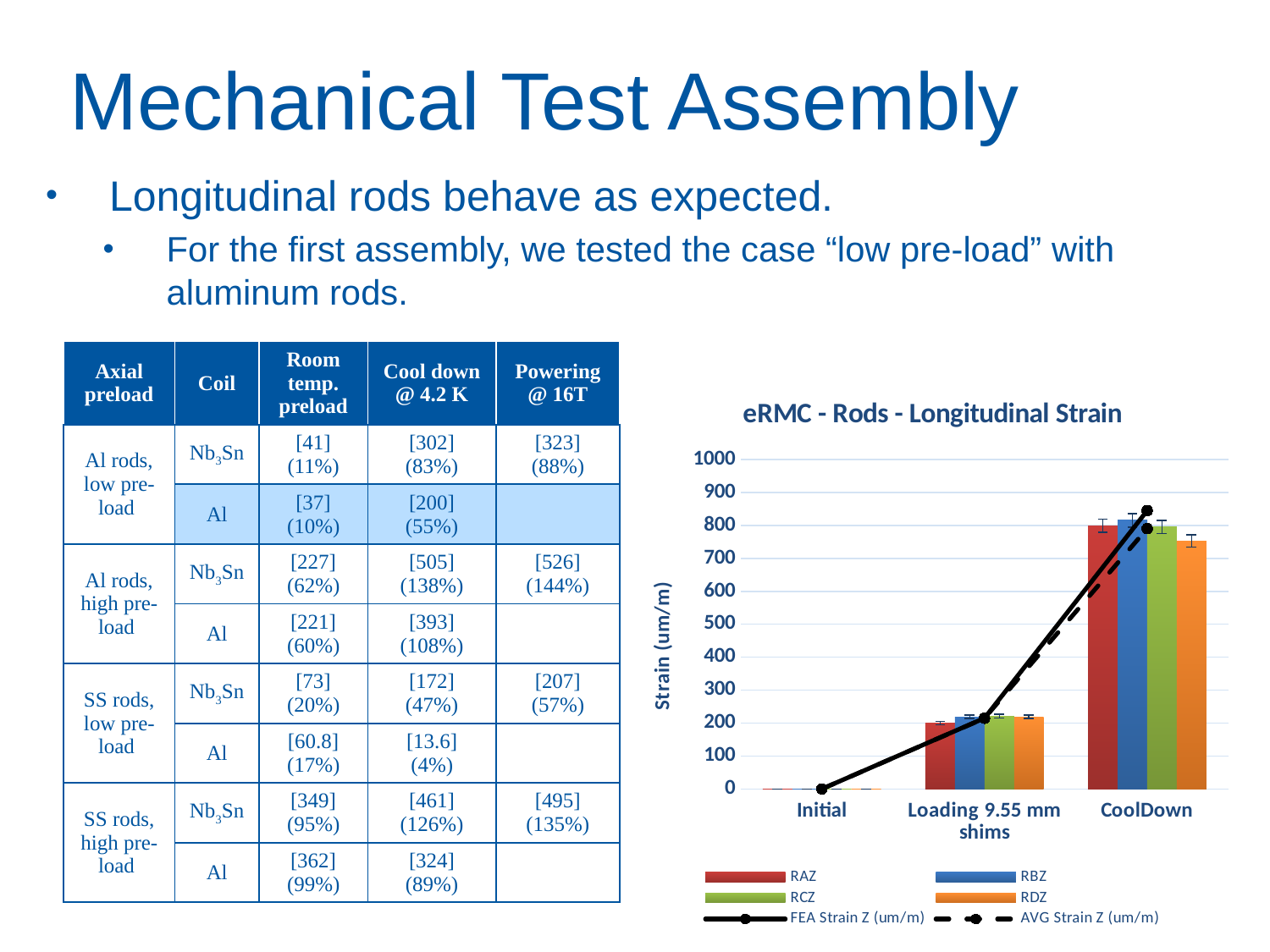
Which bar series has the lowest value at CoolDown? RDZ What is the label of the y axis of the chart? Strain (um/m) What kind of chart is shown on the slide? combination bar and line chart Is the value for RBZ at Loading 9.55 mm shims greater or less than 100? greater Is the value for RDZ at CoolDown greater or less than 800? less Is the value for RAZ at CoolDown greater or less than 700? greater What is the title of the chart on the slide? eRMC - Rods - Longitudinal Strain How many categories are shown on the x axis of the chart? 3 Do the strain values rise or fall from Initial to CoolDown along the x axis? rise How many series does the chart legend list? 6